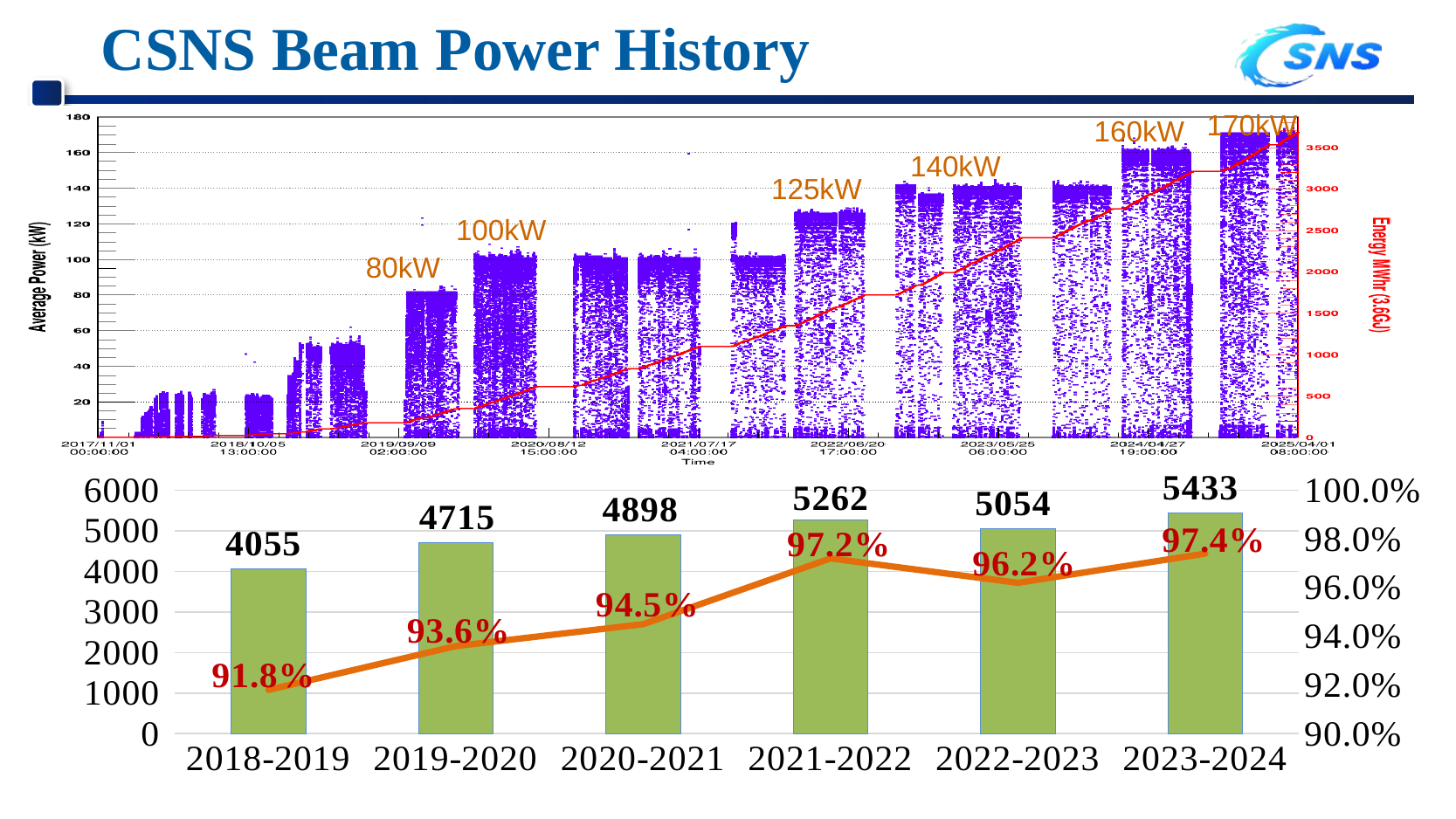
In the bottom chart, what is the bar value for 2021-2022? 5262 In the bottom chart, what percentage is shown on the line for 2020-2021? 94.5% In the bottom chart, which bar is larger: 2019-2020 or 2020-2021? 2020-2021 In the bottom chart, what percentage is shown on the line for 2022-2023? 96.2% In the bottom chart, does the percentage line generally rise or fall from 2018-2019 to 2023-2024? Rise In the bottom chart, what is the difference between the bar values for 2023-2024 and 2022-2023? 379 In the bottom chart, which period has the lowest percentage on the line? 2018-2019 In the bottom chart, how many periods are shown on the x axis? 6 What kind of chart is the bottom chart? Bar chart with a line overlay In the bottom chart, which period has the highest bar value? 2023-2024 In the top chart, what is the highest beam power level annotated? 170kW In the bottom chart, what is the bar value for 2018-2019? 4055